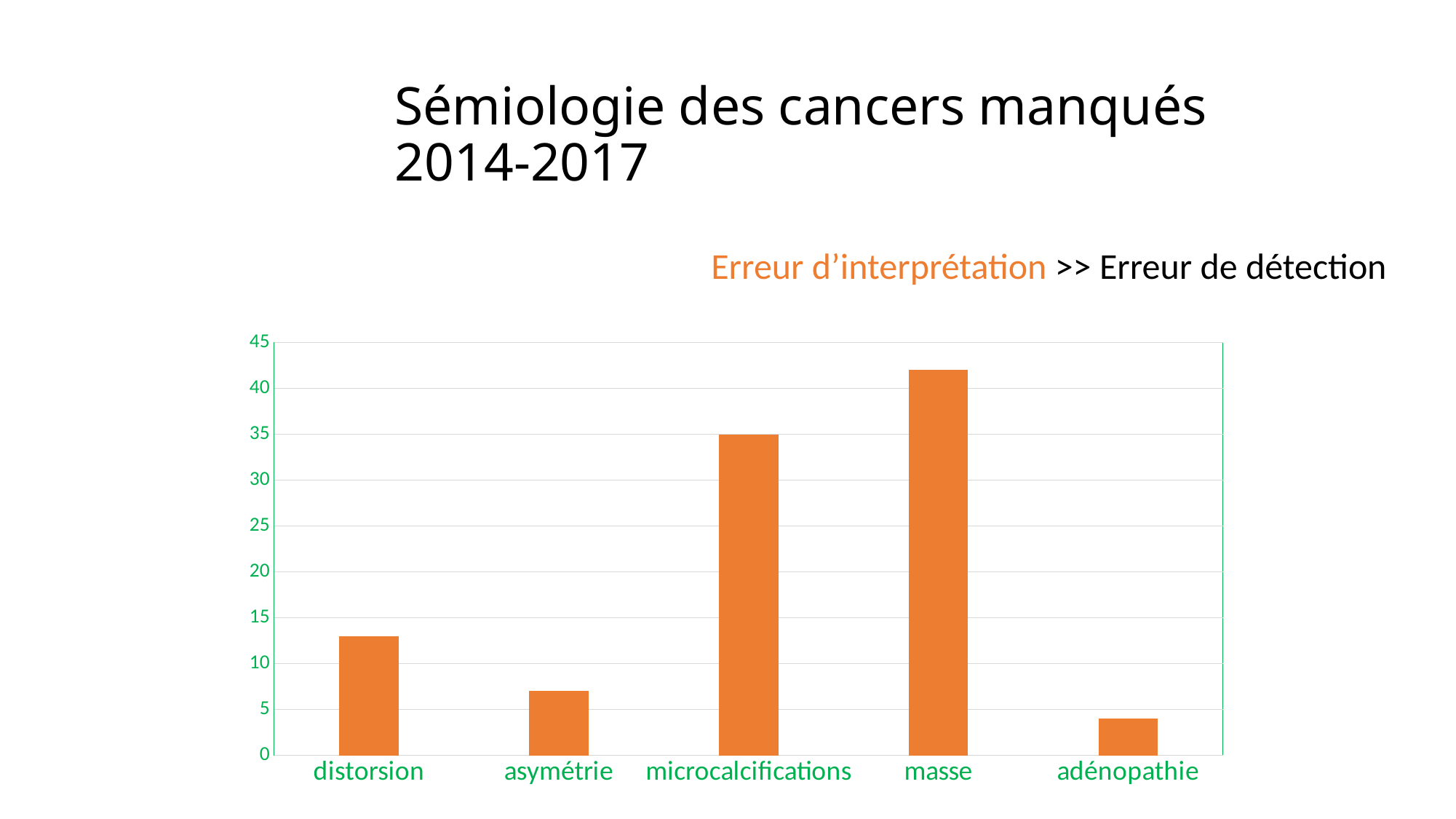
Is the value for asymétrie greater or less than 5? greater Which is larger, the value for microcalcifications or the value for masse? masse Is the value for adénopathie greater or less than 5? less What is the title of the slide containing the chart? Sémiologie des cancers manqués 2014-2017 Which category has the highest bar in the chart? masse How many categories are shown on the x axis of the chart? 5 What is the value for microcalcifications in the chart? 35 Is the value for distorsion greater or less than 15? less Which is larger, the value for distorsion or the value for asymétrie? distorsion What kind of chart is shown on the slide? bar chart Which category has the lowest bar in the chart? adénopathie